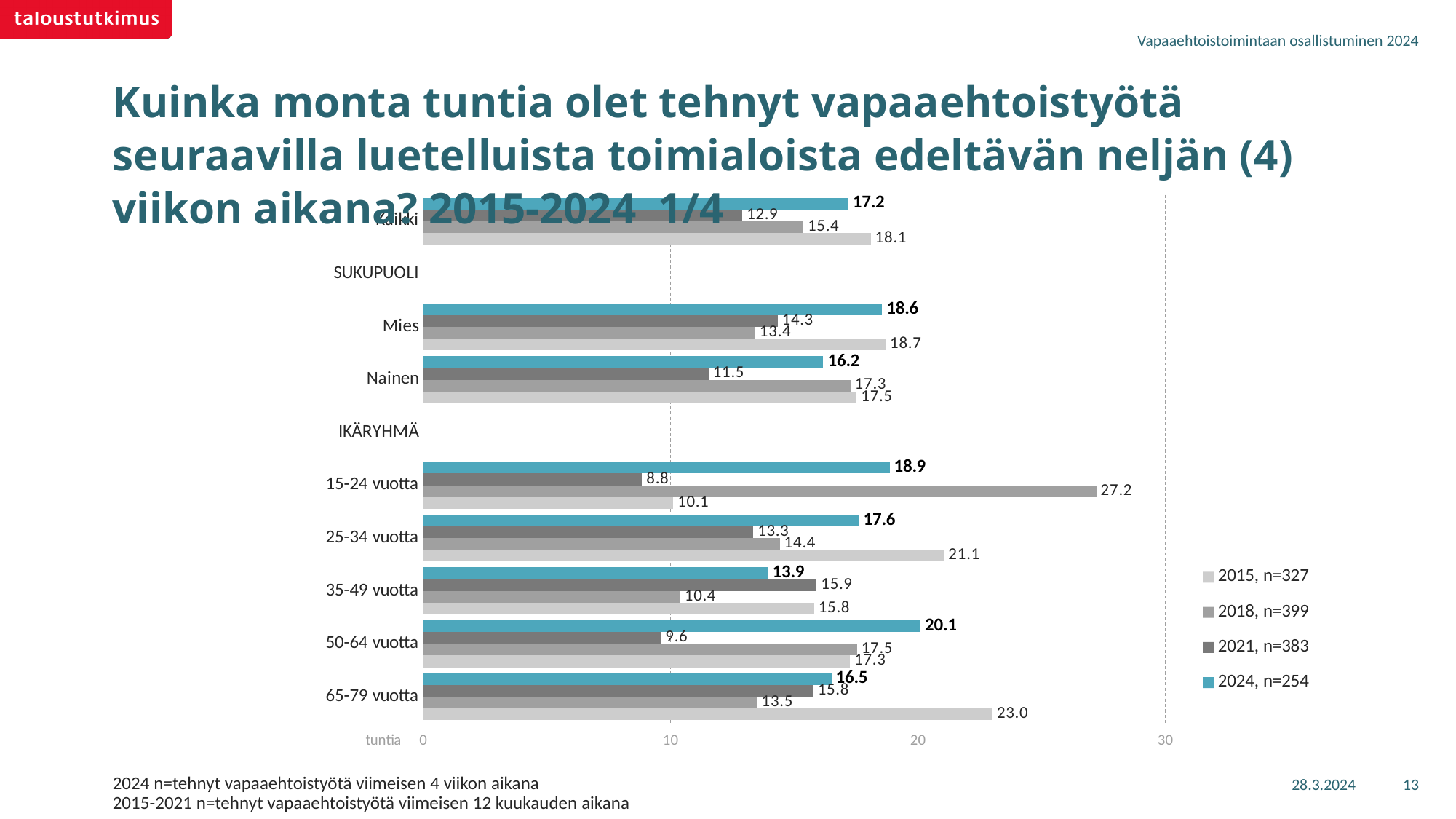
What is the 2021 value for 15-24 vuotta? 8.8 What is the difference between the 2024 values for Mies and Nainen? 2.4 Which category has the lowest 2024 value? 35-49 vuotta For 15-24 vuotta, which is larger: the 2018 value or the 2015 value? 2018 What sample size (n) does the legend give for 2024? n=254 How many series does the legend list? 4 What is the 2015 value for 65-79 vuotta? 23.0 How many categories have bars plotted in the chart? 8 Is the 2015 value for 65-79 vuotta greater or less than 20? greater What is the 2024 value for Kaikki? 17.2 Which category has the highest 2024 value? 50-64 vuotta What kind of chart is shown on the slide? bar chart